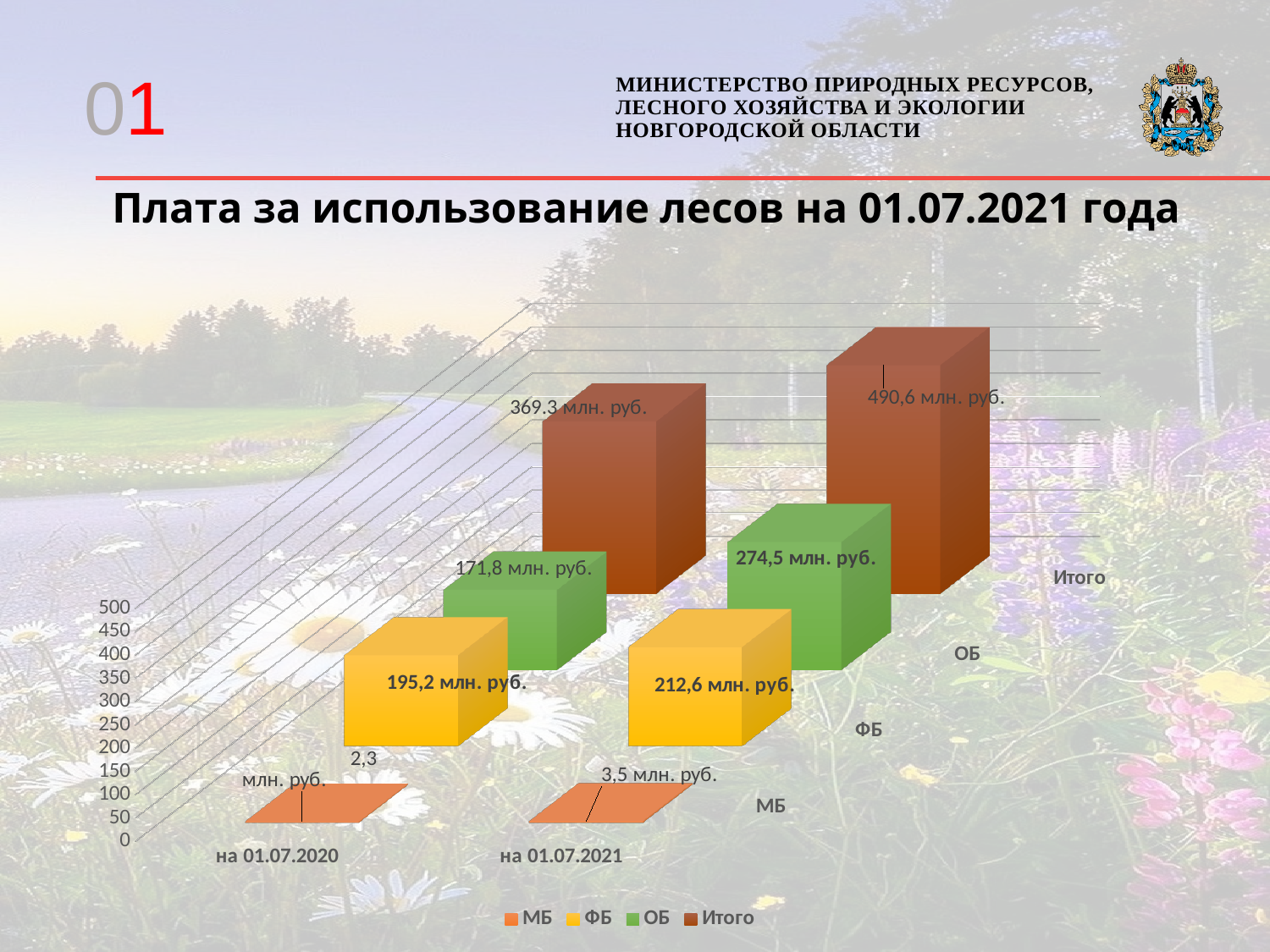
What kind of chart is shown on the slide? Bar chart What is the value of ОБ for на 01.07.2021? 274,5 млн. руб. Which is larger: ФБ for на 01.07.2020 or ОБ for на 01.07.2020? ФБ for на 01.07.2020 Which series has the highest value for на 01.07.2020? Итого What is the value of МБ for на 01.07.2020? 2,3 млн. руб. Which series has the lowest value for на 01.07.2021? МБ What is the title of the chart? Плата за использование лесов на 01.07.2021 года How many series does the legend list? 4 By how much did Итого increase from на 01.07.2020 to на 01.07.2021? 121,3 млн. руб. What is the difference between the ОБ values for на 01.07.2021 and на 01.07.2020? 102,7 млн. руб. What is the value of ФБ for на 01.07.2020? 195,2 млн. руб. What is the value of Итого for на 01.07.2021? 490,6 млн. руб.